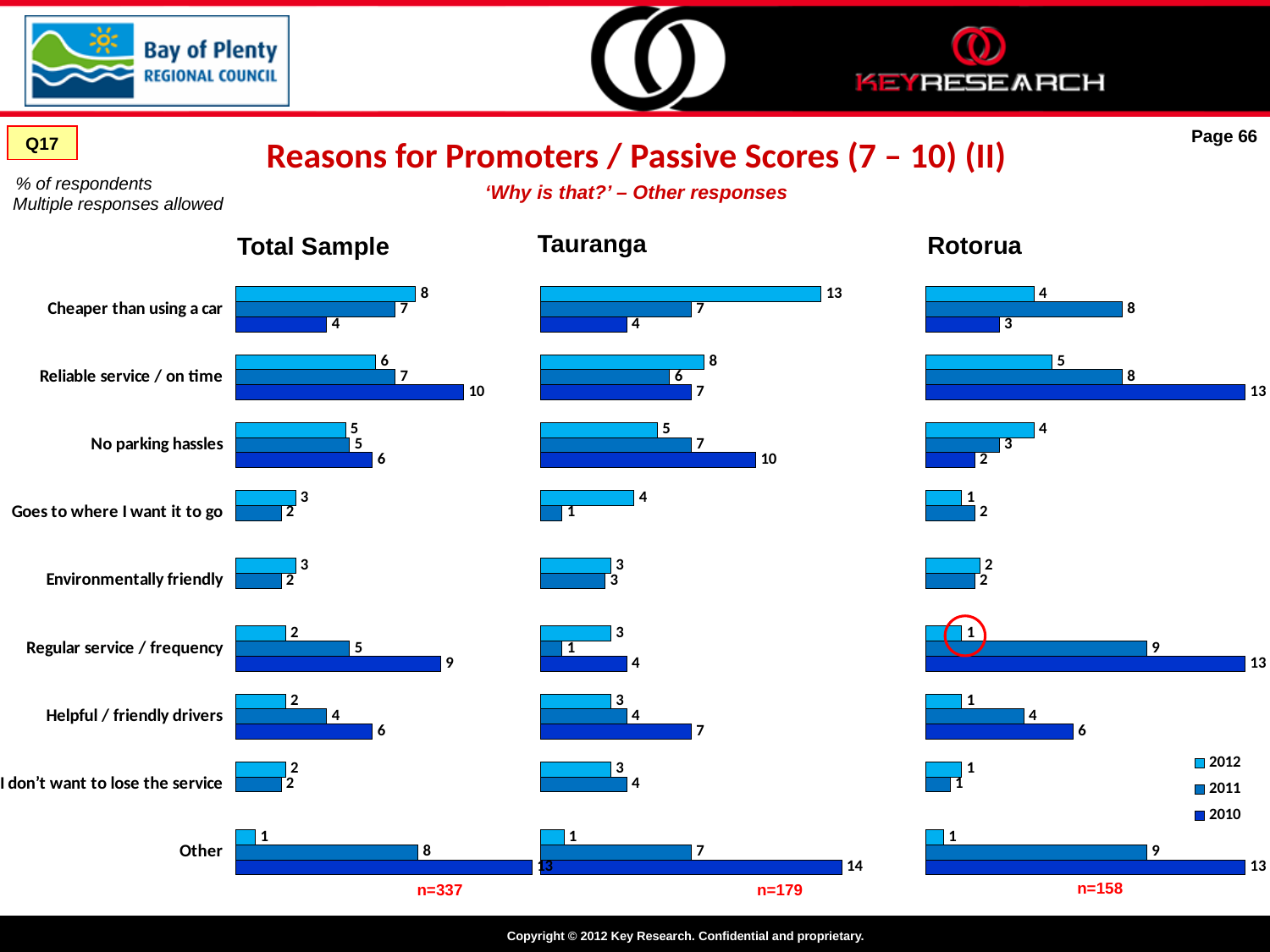
In the Rotorua chart, what is the 2011 value for Regular service / frequency? 9 In the Tauranga chart, which category has the highest 2010 value? Other In the Total Sample chart, what is the 2010 value for Reliable service / on time? 10 In the Total Sample chart, what is the difference between the 2010 and 2012 values for Regular service / frequency? 7 What is the sample size (n) shown under the Tauranga chart? n=179 In the Rotorua chart, which category has the lowest 2010 value? No parking hassles How many series does the legend list for these charts? 3 How many categories are shown in the Rotorua chart? 9 In the Tauranga chart, what is the 2012 value for Cheaper than using a car? 13 What kind of chart is the Total Sample chart? Bar chart In the Tauranga chart, which is larger for No parking hassles: the 2011 value or the 2012 value? 2011 In the Rotorua chart, what is the 2010 value for Other? 13